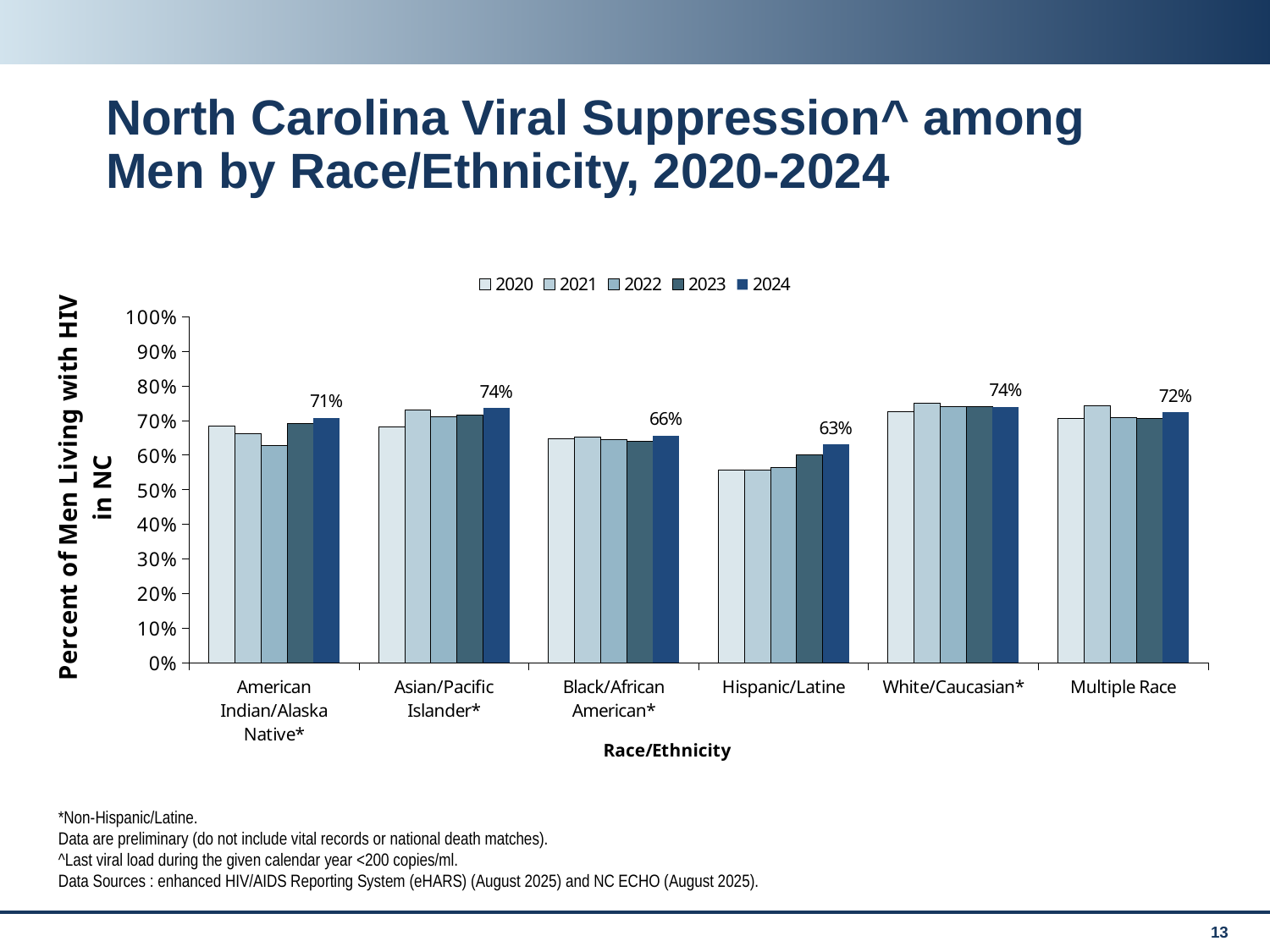
Is the 2020 value for Hispanic/Latine men greater or less than 60%? less What kind of chart is shown on the slide? Bar chart Is the 2021 value for Asian/Pacific Islander men greater or less than 70%? greater Which race/ethnicity group has the lowest 2024 value? Hispanic/Latine What is the 2024 viral suppression value for Hispanic/Latine men? 63% What is the difference between the 2024 values for White/Caucasian and Hispanic/Latine men? 11 percentage points How many race/ethnicity categories are shown on the x axis? 6 How many years (series) does the legend list? 5 What is the 2024 value for American Indian/Alaska Native men? 71% Do the values for Hispanic/Latine men rise or fall from 2020 to 2024? Rise What is the 2024 value for Black/African American men? 66% Which has the larger 2024 value, Multiple Race or Black/African American? Multiple Race